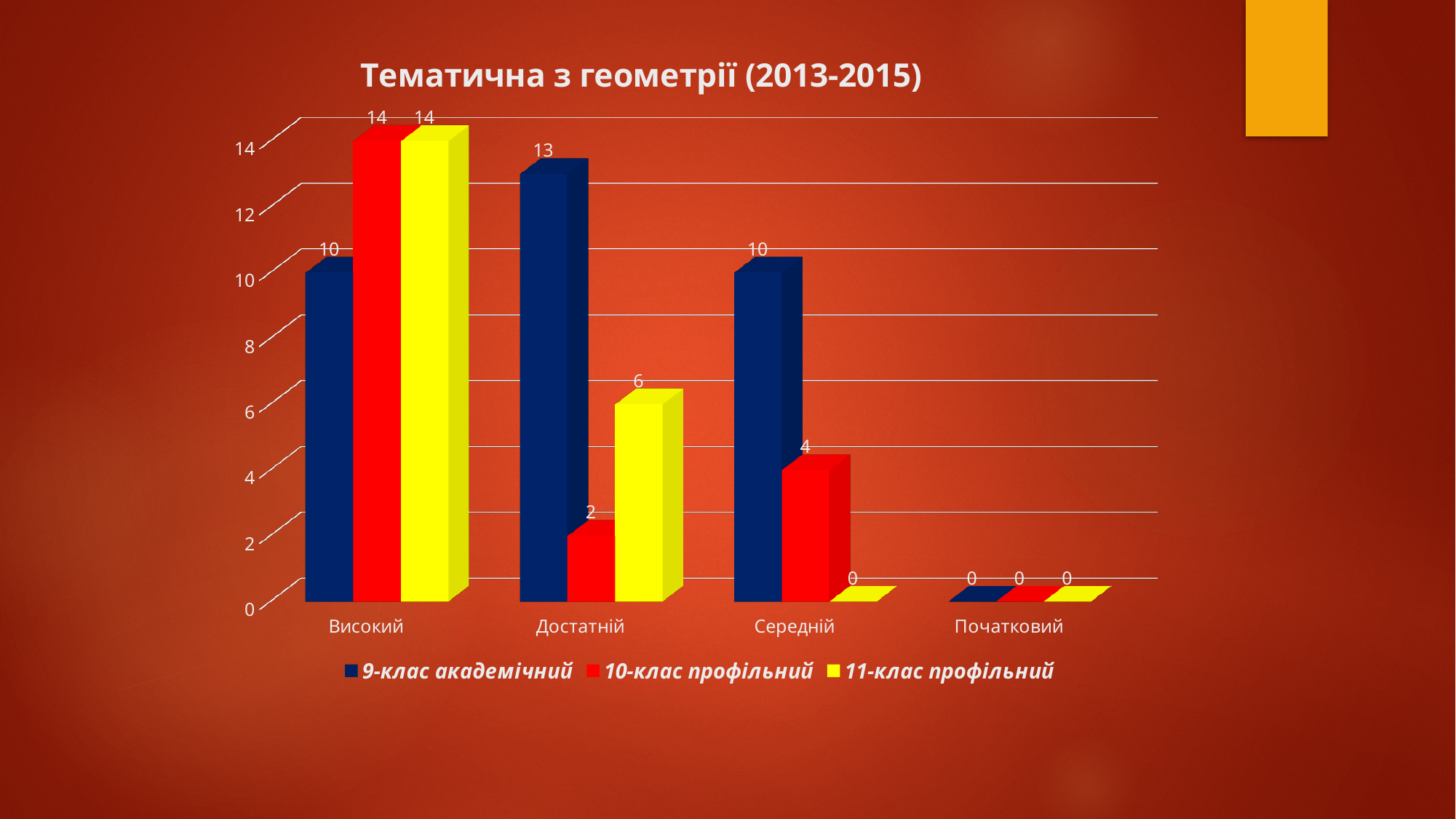
What is the value for 9-клас академічний in the Високий category? 10 What is the value for 10-клас профільний in the Достатній category? 2 What is the difference between the 9-клас академічний and 10-клас профільний values in the Середній category? 6 What kind of chart is shown on the slide? Bar chart What is the title of the chart? Тематична з геометрії (2013-2015) In which category does 11-клас профільний have its highest value? Високий How many categories are shown on the x axis? 4 In which category does 9-клас академічний have its highest value? Достатній What is the value for 11-клас профільний in the Достатній category? 6 What is the value for 11-клас профільний in the Середній category? 0 Which is larger in the Достатній category: 10-клас профільний or 11-клас профільний? 11-клас профільний How many series does the legend list? 3